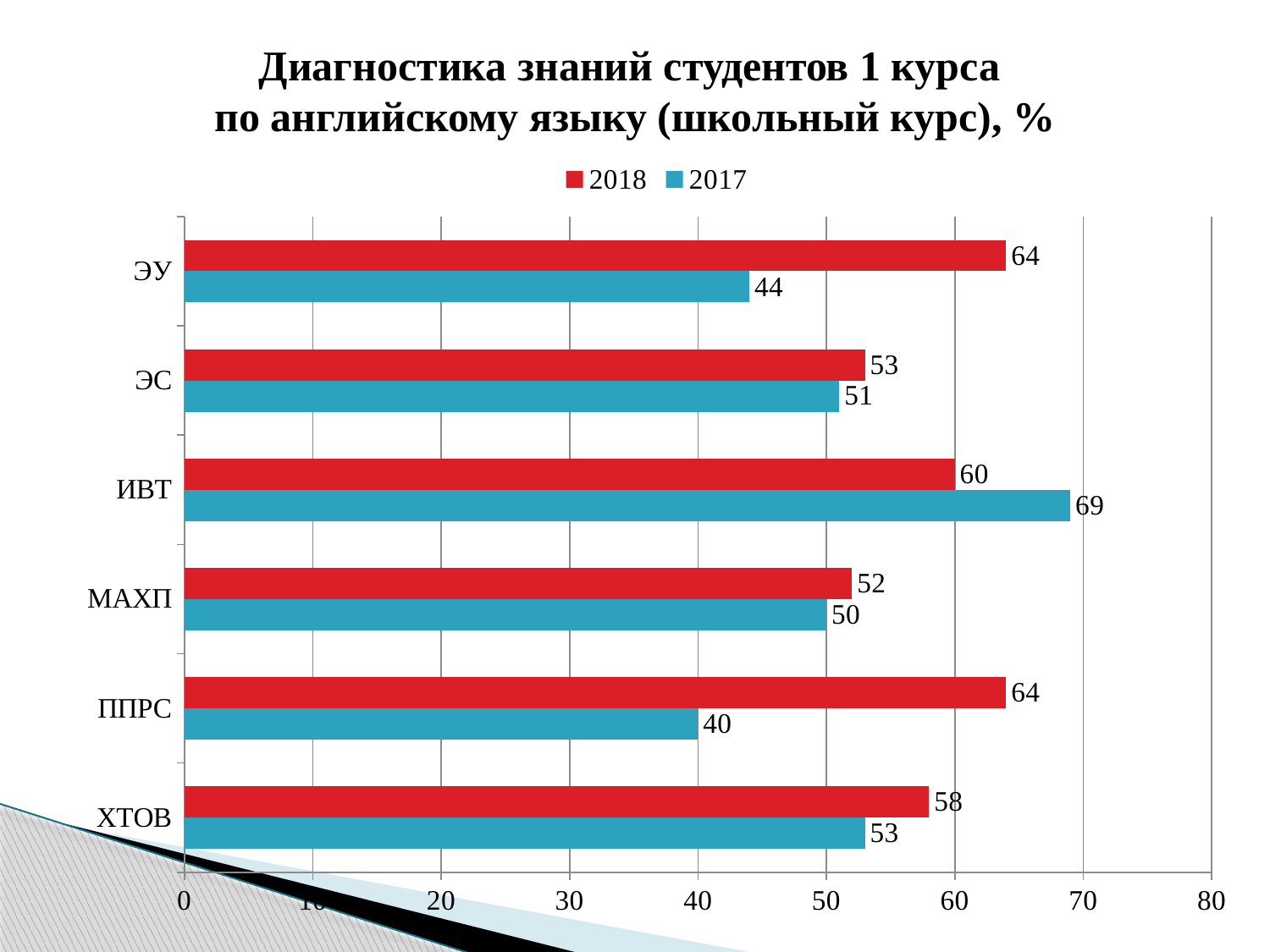
How many categories are shown on the chart? 6 Which category has the highest 2017 value? ИВТ How many series does the legend list? 2 Which category has the lowest 2017 value? ППРС What is the 2018 value for ЭУ? 64 Which is larger for ИВТ, the 2018 value or the 2017 value? 2017 What is the 2017 value for ИВТ? 69 Is the 2018 value for ХТОВ greater or less than 50? greater What is the 2017 value for ППРС? 40 Which series is shown in red? 2018 What is the difference between the 2018 and 2017 values for ППРС? 24 What type of chart is shown on the slide? bar chart